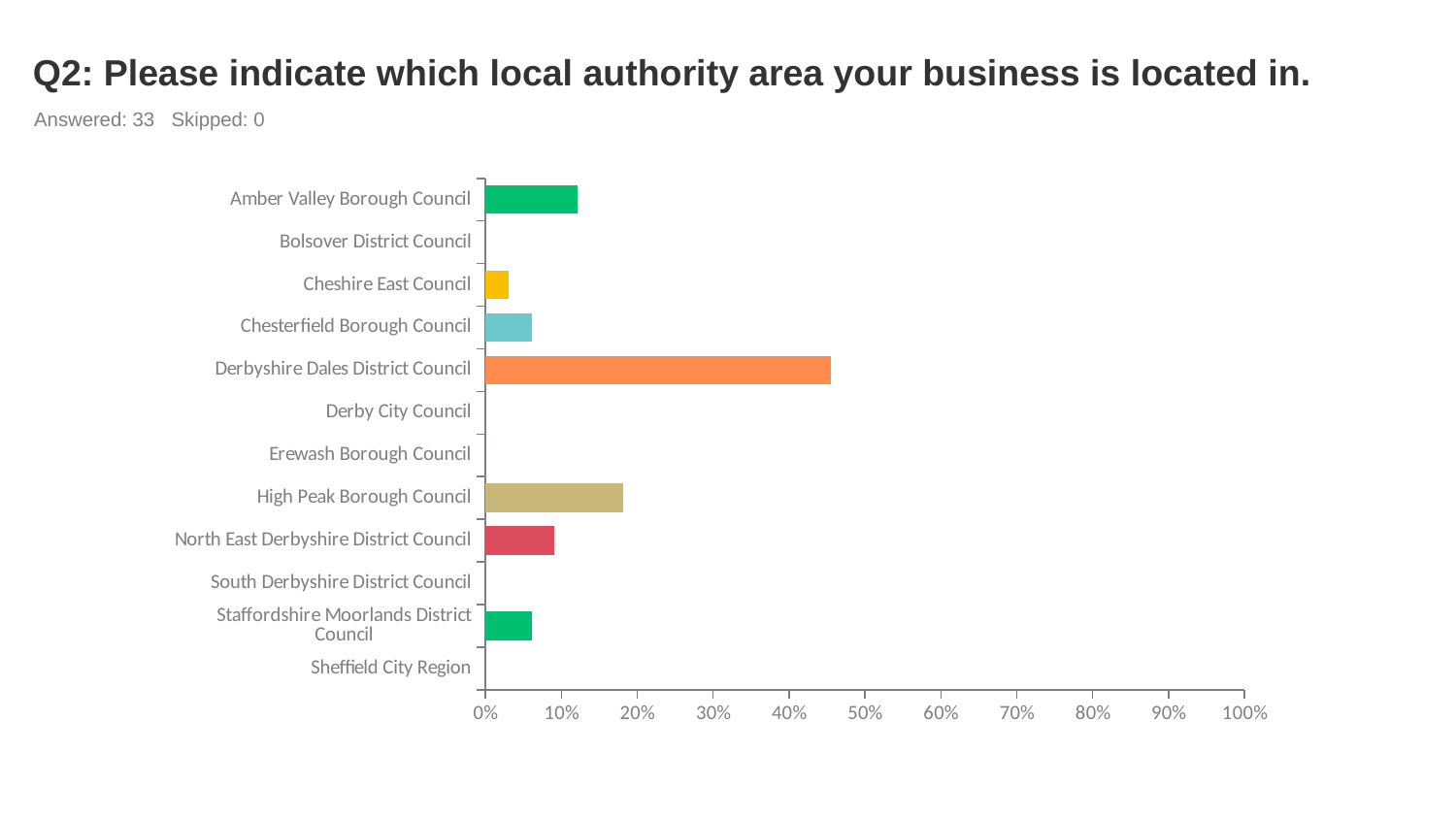
What is the maximum value shown on the horizontal axis of the chart? 100% Is the value for Cheshire East Council greater or less than 10%? less Is the value for Amber Valley Borough Council greater or less than 10%? greater How many respondents answered the question shown on the slide? 33 How many local authority areas are listed on the chart? 12 Which is larger, the value for Derbyshire Dales District Council or the value for High Peak Borough Council? Derbyshire Dales District Council Which is larger, the value for High Peak Borough Council or the value for Amber Valley Borough Council? High Peak Borough Council Is the value for Derbyshire Dales District Council greater or less than 40%? greater Which is larger, the value for North East Derbyshire District Council or the value for Cheshire East Council? North East Derbyshire District Council Which local authority area has the highest share of responses? Derbyshire Dales District Council What type of chart is shown on the slide? Bar chart